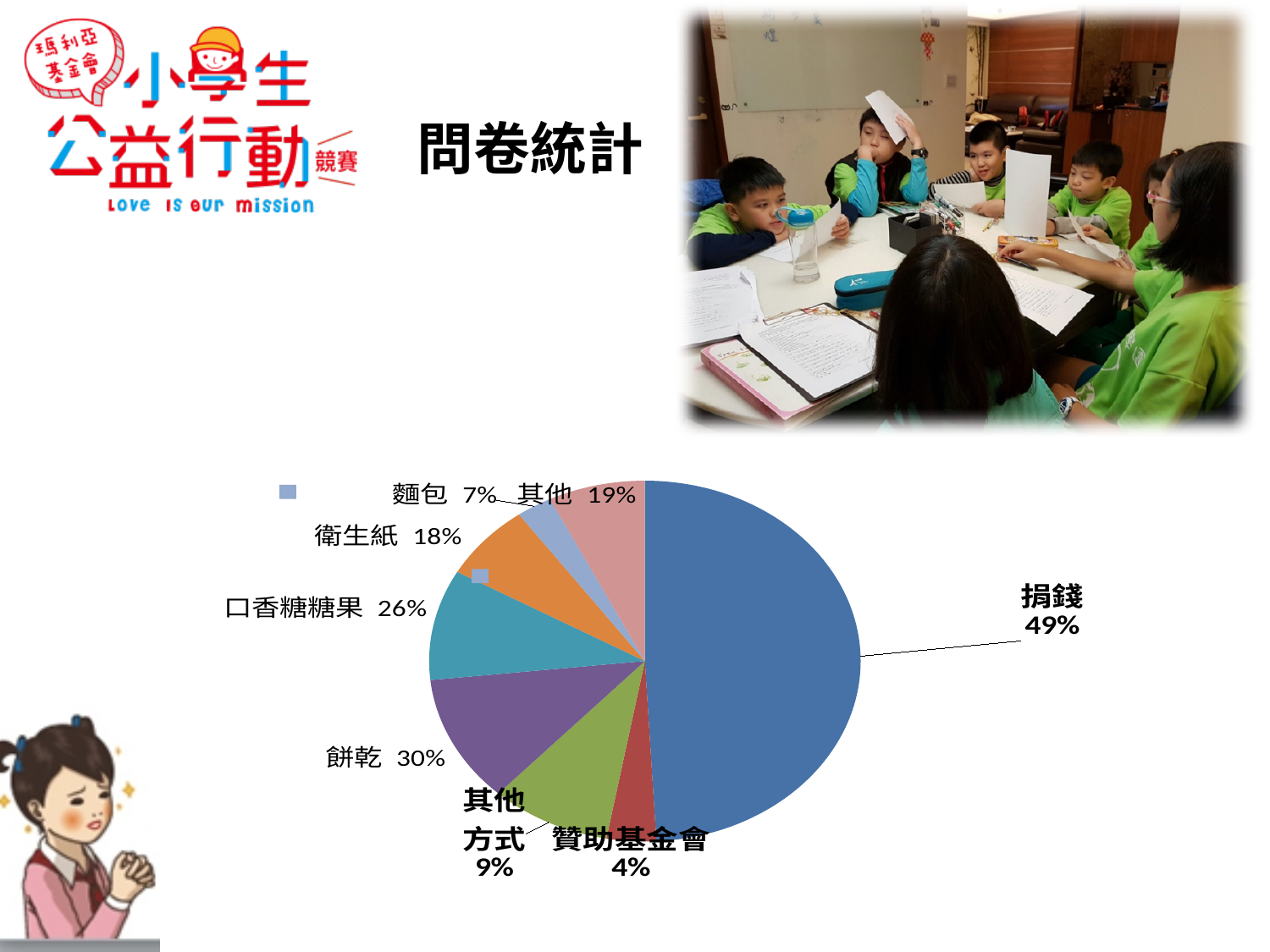
What is the value shown for 贊助基金會 in the pie chart? 4% What kind of chart is shown on the slide? pie chart What is the value shown for 餅乾 in the pie chart? 30% What colour is the 捐錢 slice in the pie chart? blue How many slices does the pie chart have? 8 What is the value shown for 捐錢 in the pie chart? 49% What is the value shown for 口香糖糖果 in the pie chart? 26% Which category has the largest slice in the pie chart? 捐錢 What is the difference between the values for 捐錢 and 餅乾? 19% Which is larger, the value for 餅乾 or the value for 口香糖糖果? 餅乾 Which category has the smallest slice in the pie chart? 贊助基金會 What is the value shown for 衛生紙 in the pie chart? 18%